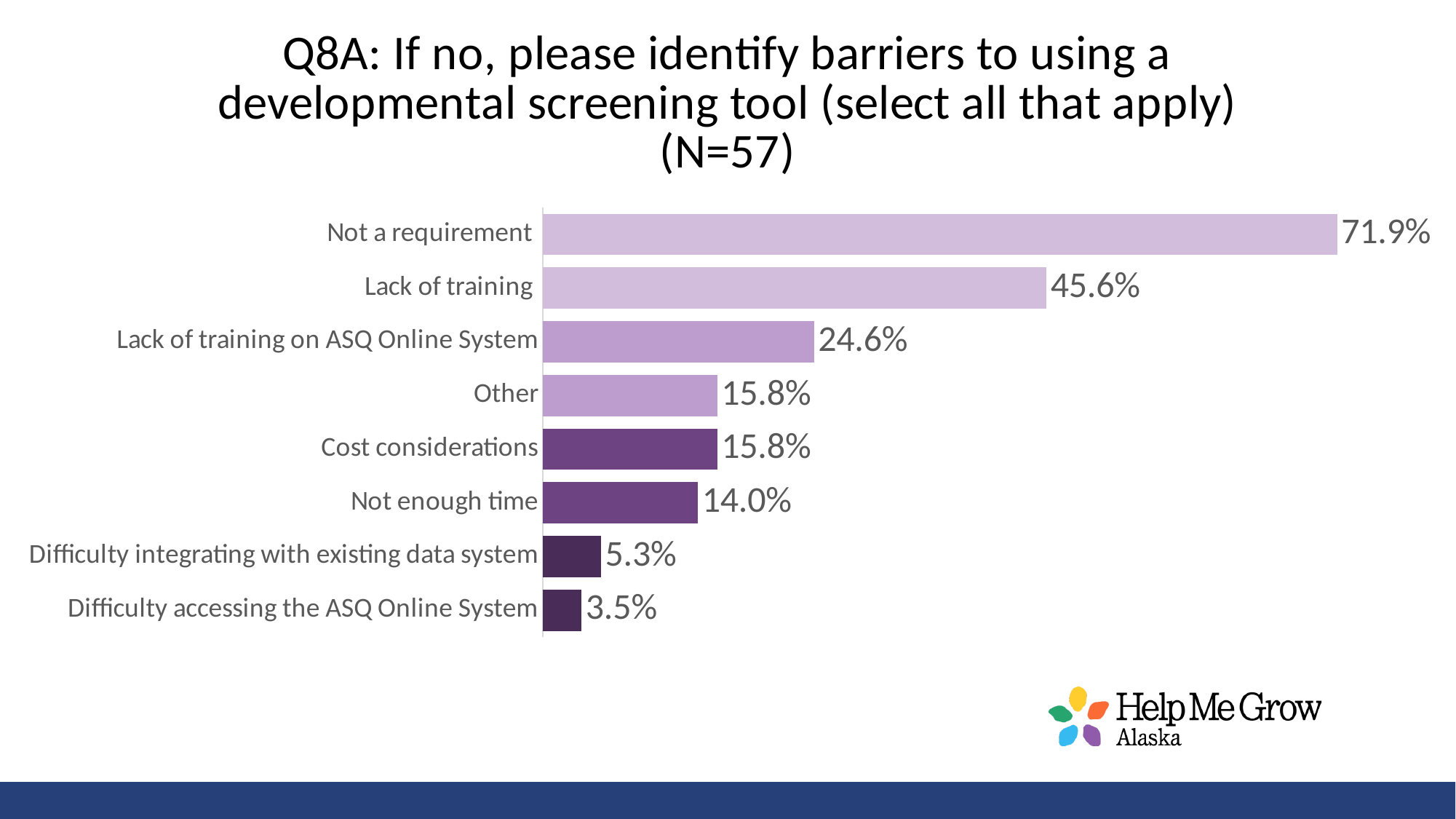
What is the difference in percentage points between "Lack of training" and "Lack of training on ASQ Online System"? 21.0 What percentage is shown for "Not enough time"? 14.0% What is the value for "Difficulty integrating with existing data system"? 5.3% What type of chart is shown on the slide? Bar chart Which has a higher percentage, "Cost considerations" or "Not enough time"? Cost considerations What is the sample size (N) stated in the chart title? 57 How many barrier categories are shown in the chart? 8 What is the difference in percentage points between "Not a requirement" and "Lack of training"? 26.3 Which barrier has the lowest percentage? Difficulty accessing the ASQ Online System Which barrier has the highest percentage? Not a requirement What is the value shown for "Lack of training on ASQ Online System"? 24.6% What percentage of respondents identified "Not a requirement" as a barrier? 71.9%